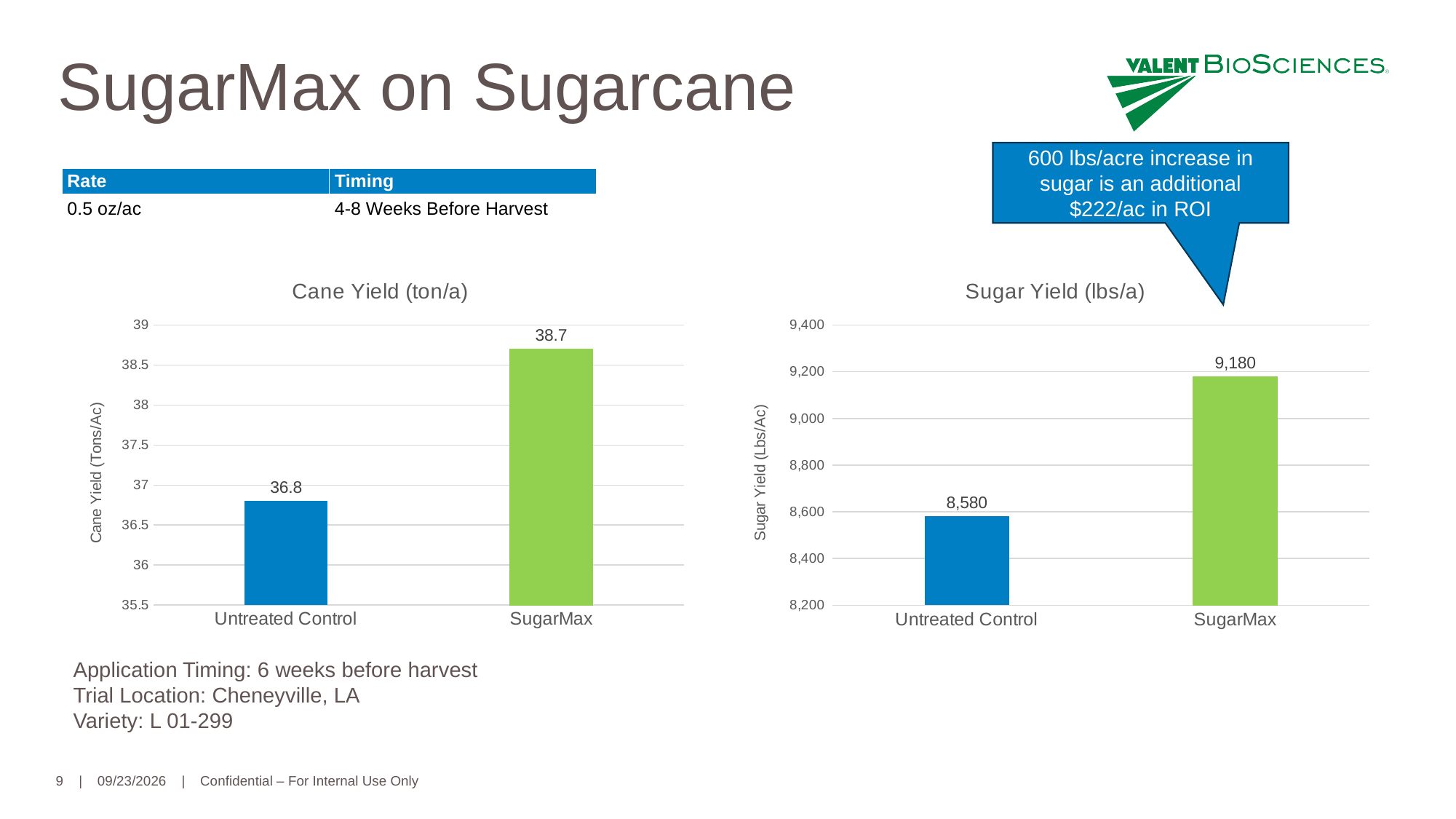
In the Cane Yield (ton/a) chart, what is the value for Untreated Control? 36.8 In the Sugar Yield (lbs/a) chart, is the value for Untreated Control greater or less than 8,600? less In the Sugar Yield (lbs/a) chart, what is the value for Untreated Control? 8,580 In the Cane Yield (ton/a) chart, what is the difference between SugarMax and Untreated Control? 1.9 In the Cane Yield (ton/a) chart, what is the value for SugarMax? 38.7 How many categories are shown in the Cane Yield (ton/a) chart? 2 In the Sugar Yield (lbs/a) chart, what is the value for SugarMax? 9,180 In the Sugar Yield (lbs/a) chart, what is the difference between SugarMax and Untreated Control? 600 What is the y-axis label of the Cane Yield (ton/a) chart? Cane Yield (Tons/Ac) What kind of chart is the Sugar Yield (lbs/a) chart? bar chart In the Sugar Yield (lbs/a) chart, which category has the lowest value? Untreated Control In the Cane Yield (ton/a) chart, which category has the highest value? SugarMax